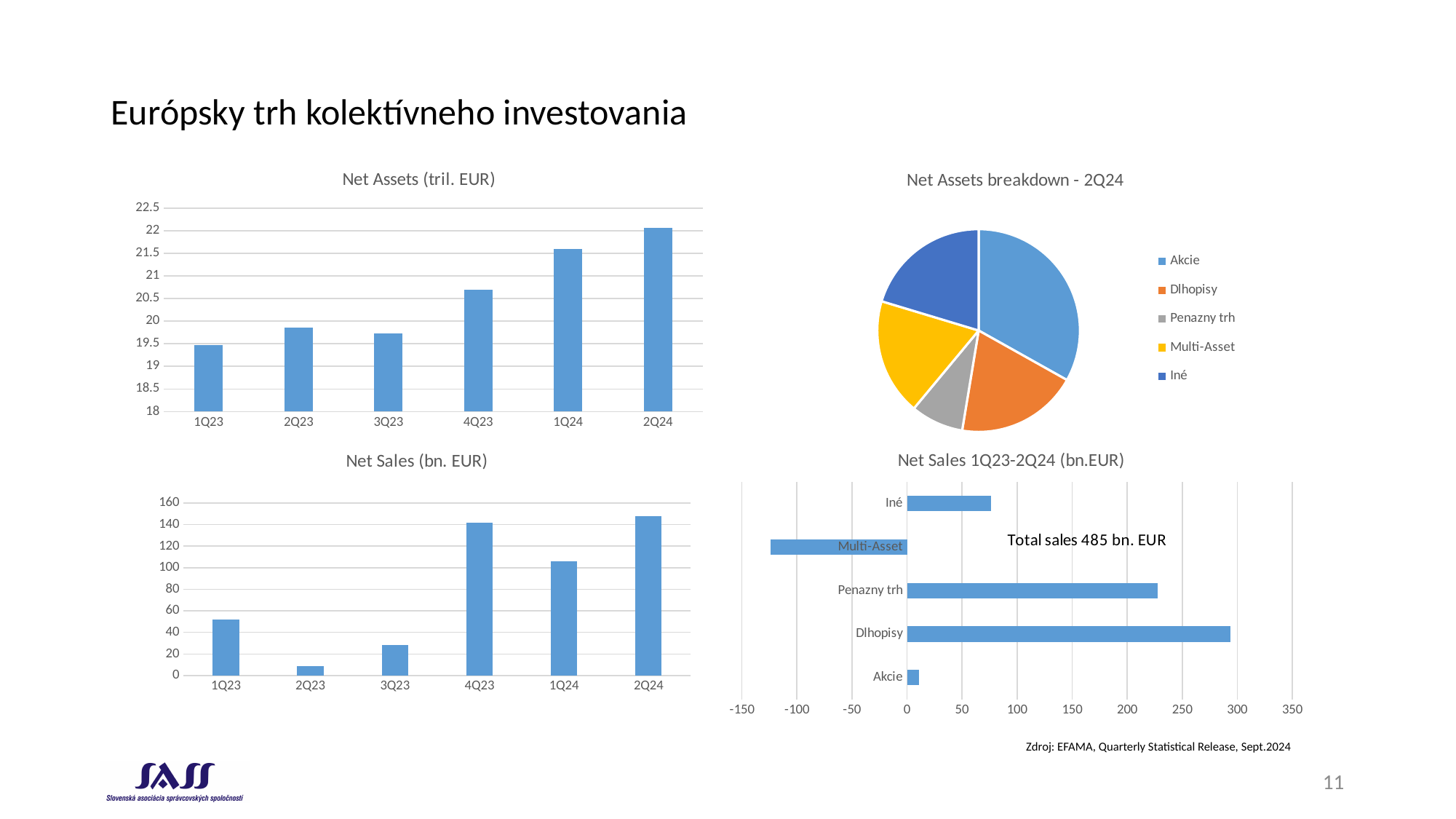
In the Net Sales 1Q23-2Q24 (bn.EUR) chart, which category has the highest net sales? Dlhopisy In the Net Sales (bn. EUR) chart, is the value for 1Q24 greater or less than 100? greater In the Net Sales (bn. EUR) chart, which quarter has the lowest net sales? 2Q23 In the Net Assets (tril. EUR) chart, which quarter has the lowest net assets? 1Q23 What total sales figure is printed on the Net Sales 1Q23-2Q24 (bn.EUR) chart? 485 bn. EUR How many categories does the legend of the Net Assets breakdown - 2Q24 chart list? 5 In the Net Assets (tril. EUR) chart, is the value for 1Q24 greater or less than 21? greater In the Net Assets (tril. EUR) chart, which quarter has the highest net assets? 2Q24 In the Net Sales (bn. EUR) chart, which is larger, the value for 1Q23 or the value for 3Q23? 1Q23 In the Net Sales 1Q23-2Q24 (bn.EUR) chart, is the value for Multi-Asset greater or less than -100? less In the Net Assets (tril. EUR) chart, how many quarters are plotted? 6 In the Net Assets breakdown - 2Q24 pie chart, which category has the largest share? Akcie